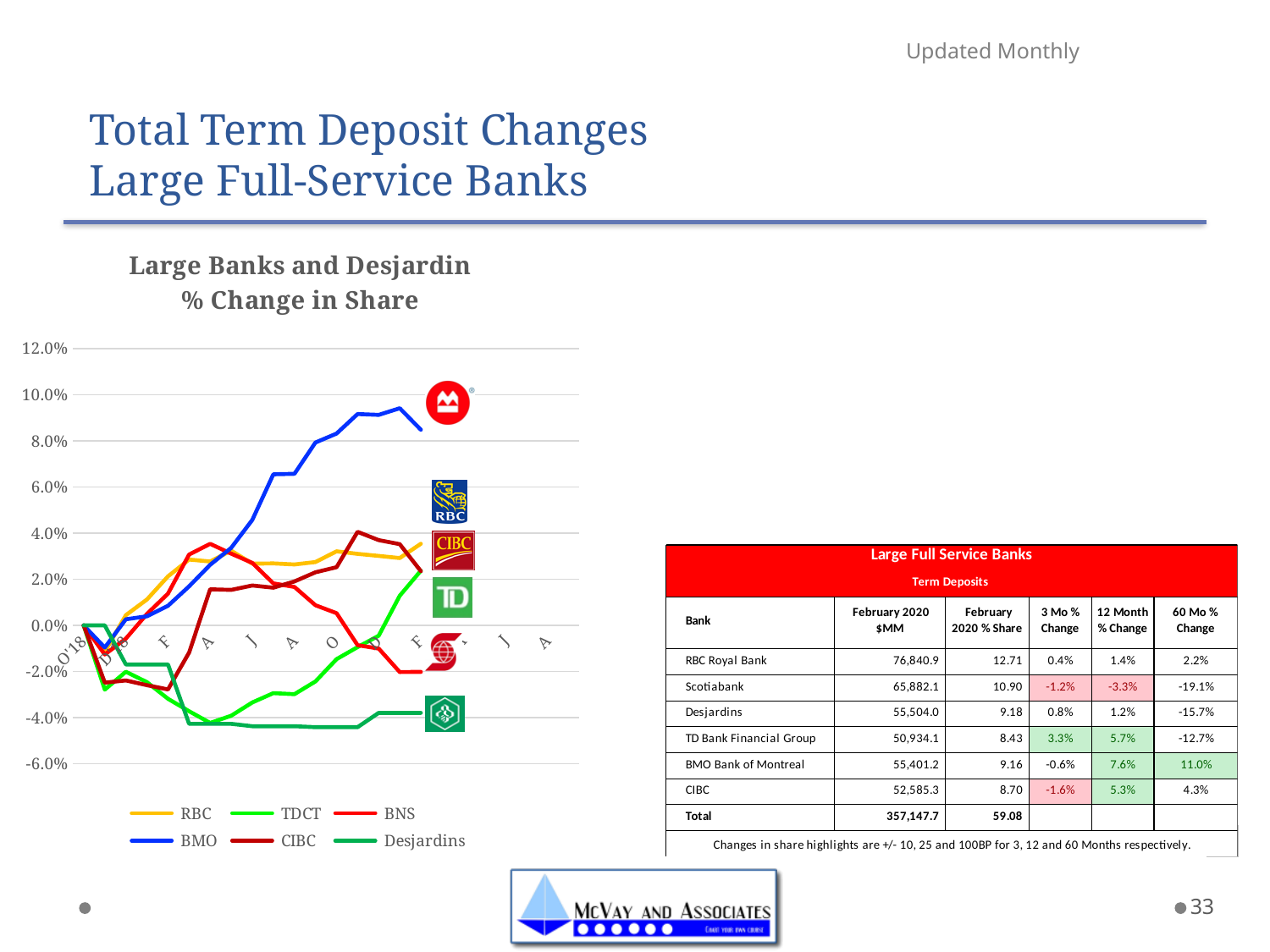
How many series does the chart legend list? 6 Which series reaches the highest point on the chart? BMO What kind of chart is shown on the slide? line chart Is the final value of the BMO line greater or less than 8.0%? greater What colour is the BMO line in the legend? blue What is the title of the chart? Large Banks and Desjardin % Change in Share Is the final value of the BNS line greater or less than 0.0%? less Does the BMO line generally rise or fall from left to right across the chart? rise At the right end of the chart, which line is higher, BMO or RBC? BMO At the right end of the chart, which line is higher, CIBC or BNS? CIBC Is the final value of the Desjardins line greater or less than -2.0%? less Which series reaches the lowest point on the chart? Desjardins